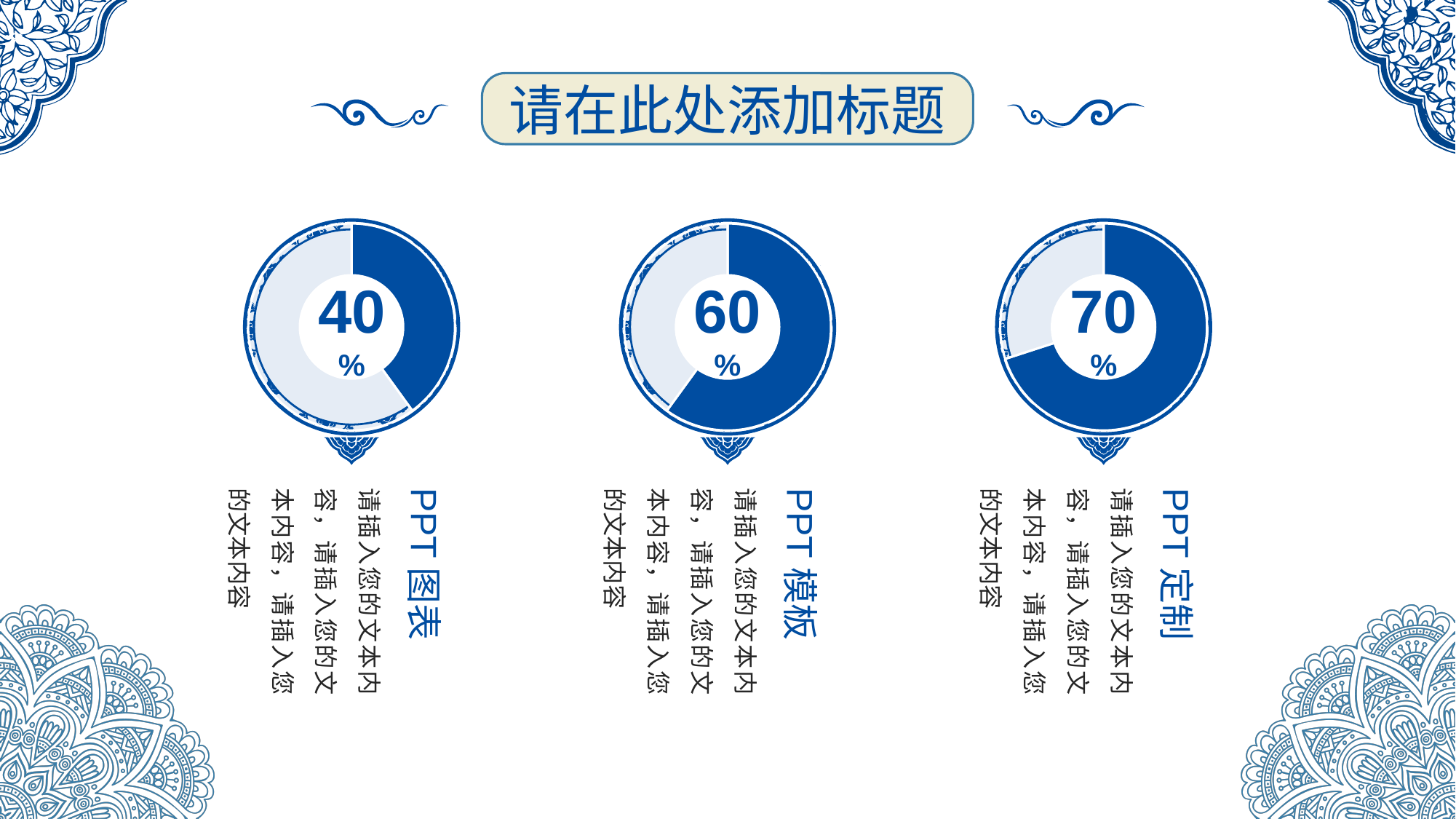
How many donut charts are on the slide? 3 Which of the three donut charts shows the highest percentage? PPT 定制 (right chart, 70%) Which is larger, the percentage in the middle chart (PPT 模板) or the right chart (PPT 定制)? PPT 定制 (right chart) Do the percentages increase or decrease from the left chart to the right chart? Increase Which of the three donut charts shows the lowest percentage? PPT 图表 (left chart, 40%) What is the difference between the percentage in the right chart (PPT 定制) and the left chart (PPT 图表)? 30% What percentage is shown in the left donut chart (PPT 图表)? 40% What percentage is shown in the right donut chart (PPT 定制)? 70% What is the title of the slide? 请在此处添加标题 What is the difference between the percentage in the middle chart (PPT 模板) and the left chart (PPT 图表)? 20% What percentage is shown in the middle donut chart (PPT 模板)? 60% What kind of chart is used to display the percentages on the slide? Donut (pie) chart